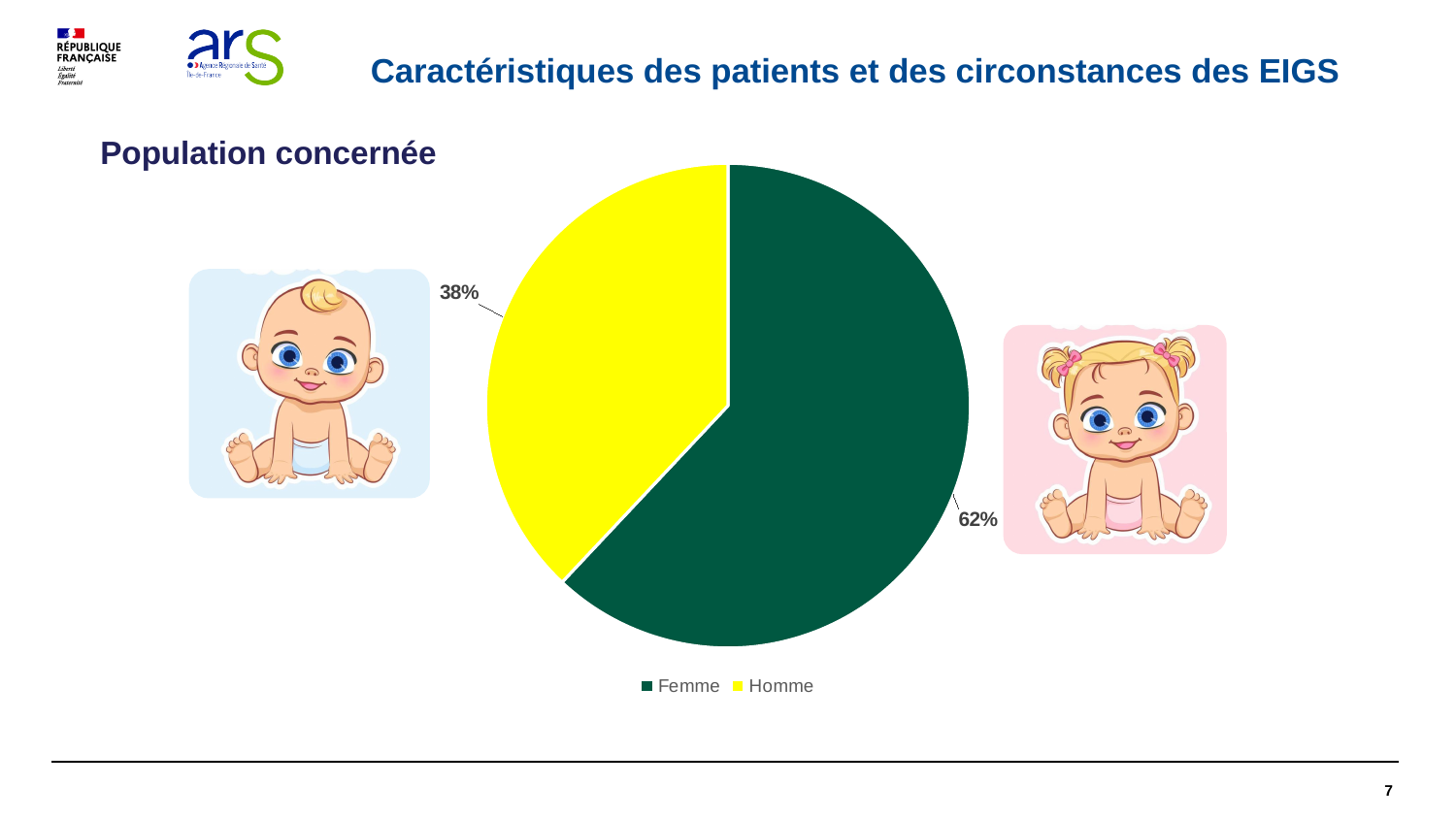
Which category has the smallest slice in the pie chart? Homme Which category has the largest slice in the pie chart? Femme How many slices does the pie chart have? 2 What share of the pie chart is Femme? 62% How many entries does the legend list? 2 What colour is the Homme slice in the pie chart? Yellow What kind of chart is shown on the slide? Pie chart What colour is the Femme slice in the pie chart? Dark green What is the difference in percentage points between the Femme and Homme slices? 24 Which slice is larger, Femme or Homme? Femme What share of the pie chart is Homme? 38%